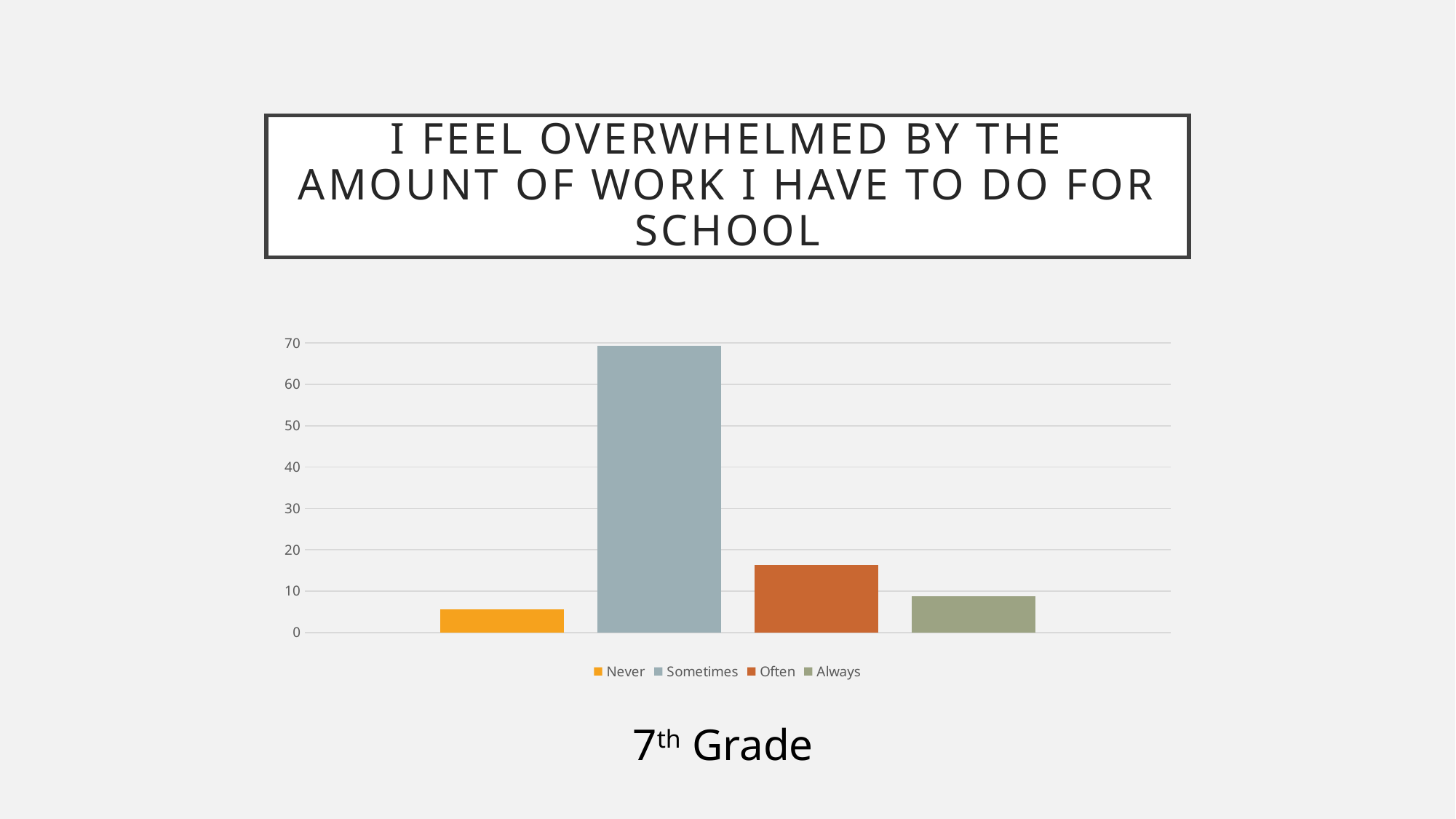
Is the value for Often greater or less than 10? greater Which is larger, the value for Never or the value for Always? Always Is the value for Sometimes greater or less than 60? greater What kind of chart is shown on the slide? bar chart How many bars are plotted in the chart? 4 Which response has the highest value? Sometimes Which grade does the chart's data refer to, according to the label below the chart? 7th Grade How many series does the legend list? 4 Is the value for Often greater or less than 20? less Which is larger, the value for Often or the value for Always? Often Which response has the lowest value? Never